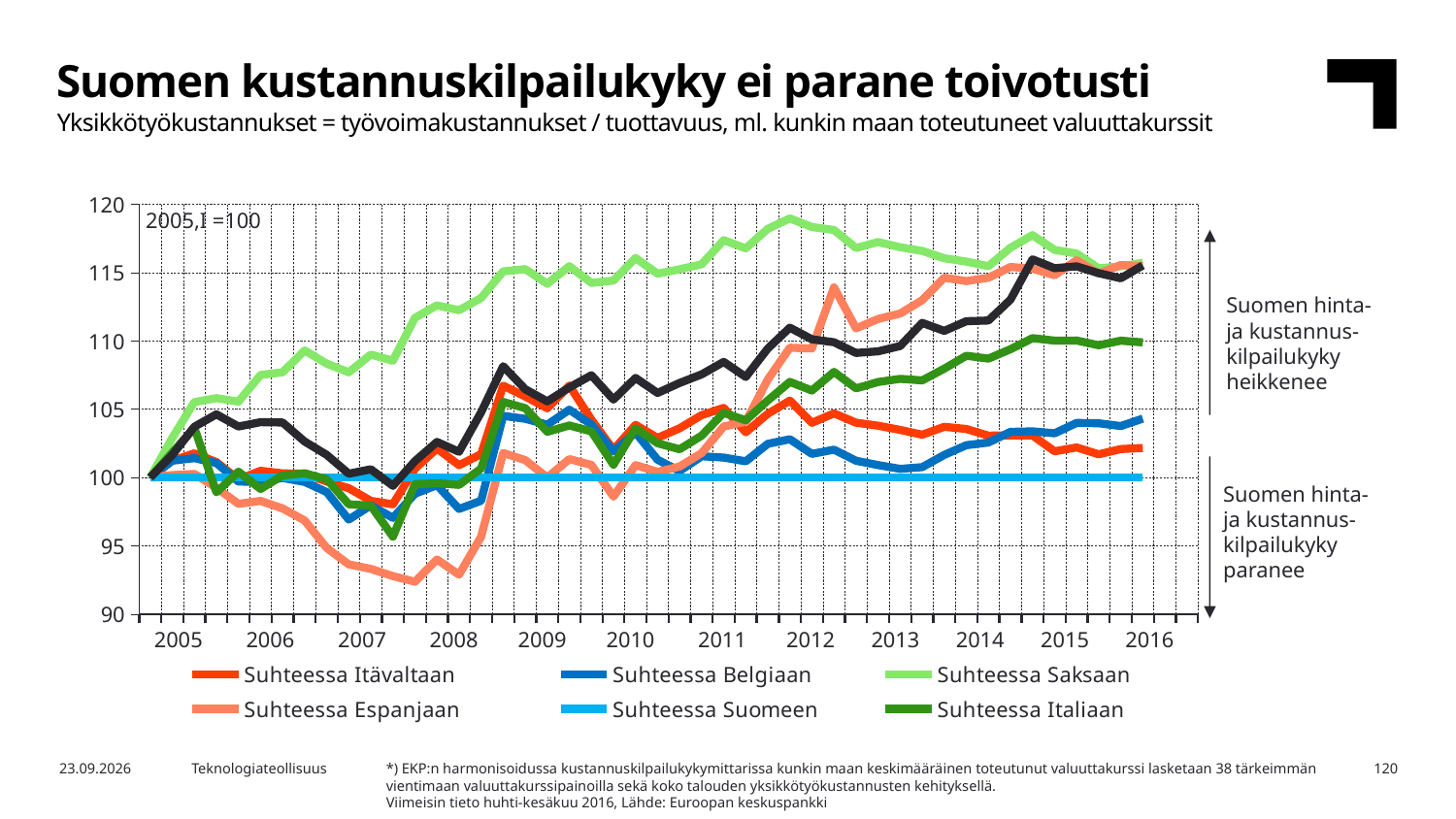
Is the value for 'Suhteessa Espanjaan' in 2008 greater or less than 95? less What constant value does the 'Suhteessa Suomeen' line hold across the whole period? 100 What kind of chart is shown on the slide? line chart Is the value for 'Suhteessa Italiaan' in 2016 greater or less than 105? greater Which series has the highest value in 2012? Suhteessa Saksaan In 2016, which is larger: 'Suhteessa Saksaan' or 'Suhteessa Belgiaan'? Suhteessa Saksaan What is the base index value stated in the chart (2005,I = ?) 100 How many series does the legend list? 6 Which series has the lowest value in 2008? Suhteessa Espanjaan Is the value for 'Suhteessa Saksaan' in 2012 greater or less than 115? greater Does the 'Suhteessa Saksaan' line rise or fall from 2005 to 2012? rise